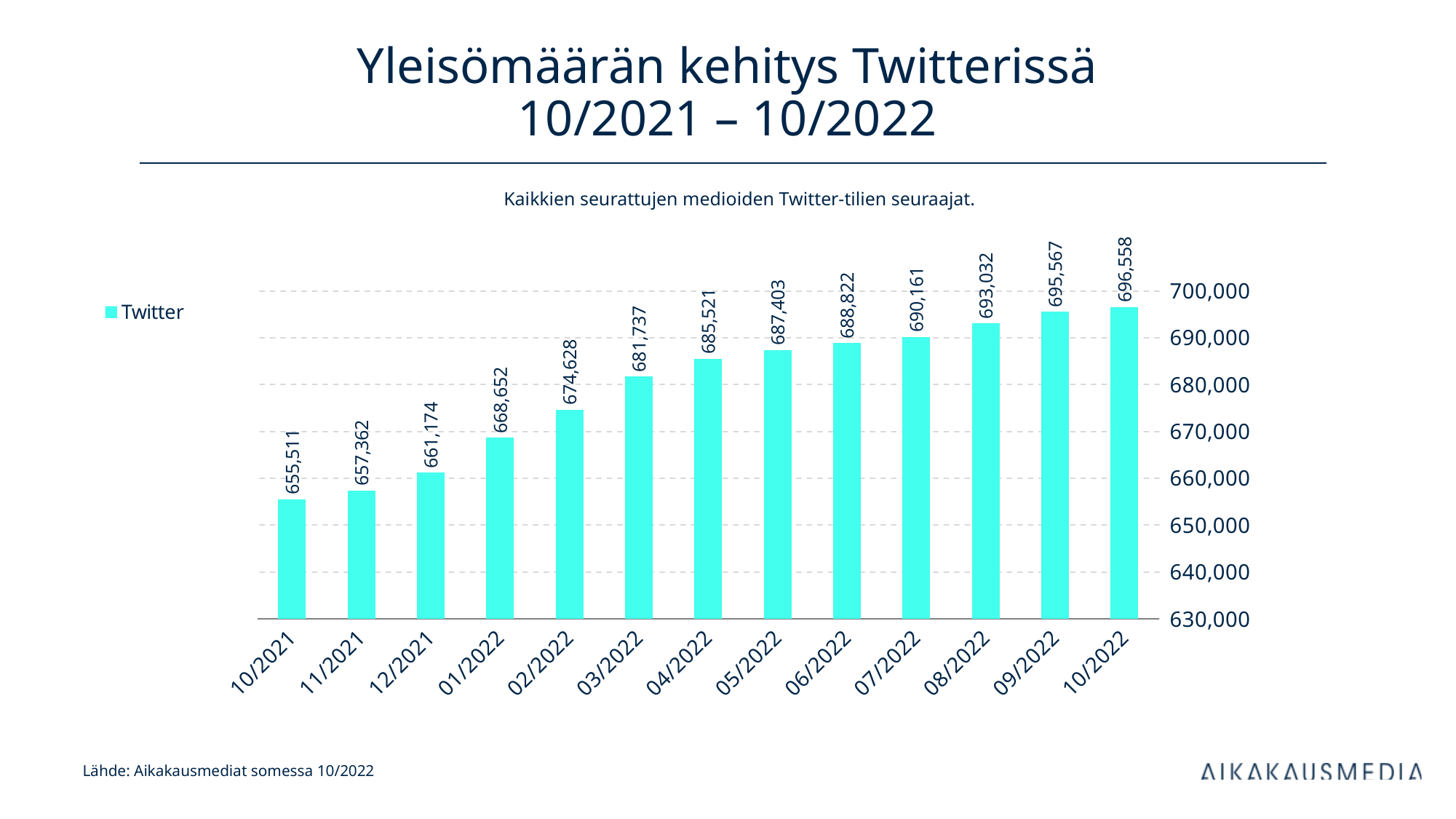
What kind of chart is shown? bar chart Which month has the highest value? 10/2022 What is the difference between the values for 10/2022 and 10/2021? 41,047 What is the value for 03/2022? 681,737 What is the value for 10/2022? 696,558 Which is larger, the value for 05/2022 or the value for 04/2022? 05/2022 How many months are shown on the x axis? 13 Is the value for 06/2022 greater or less than 680,000? greater Do the values rise or fall from 10/2021 to 10/2022? rise Which month has the lowest value? 10/2021 What is the difference between the values for 02/2022 and 01/2022? 5,976 What is the value for 10/2021? 655,511